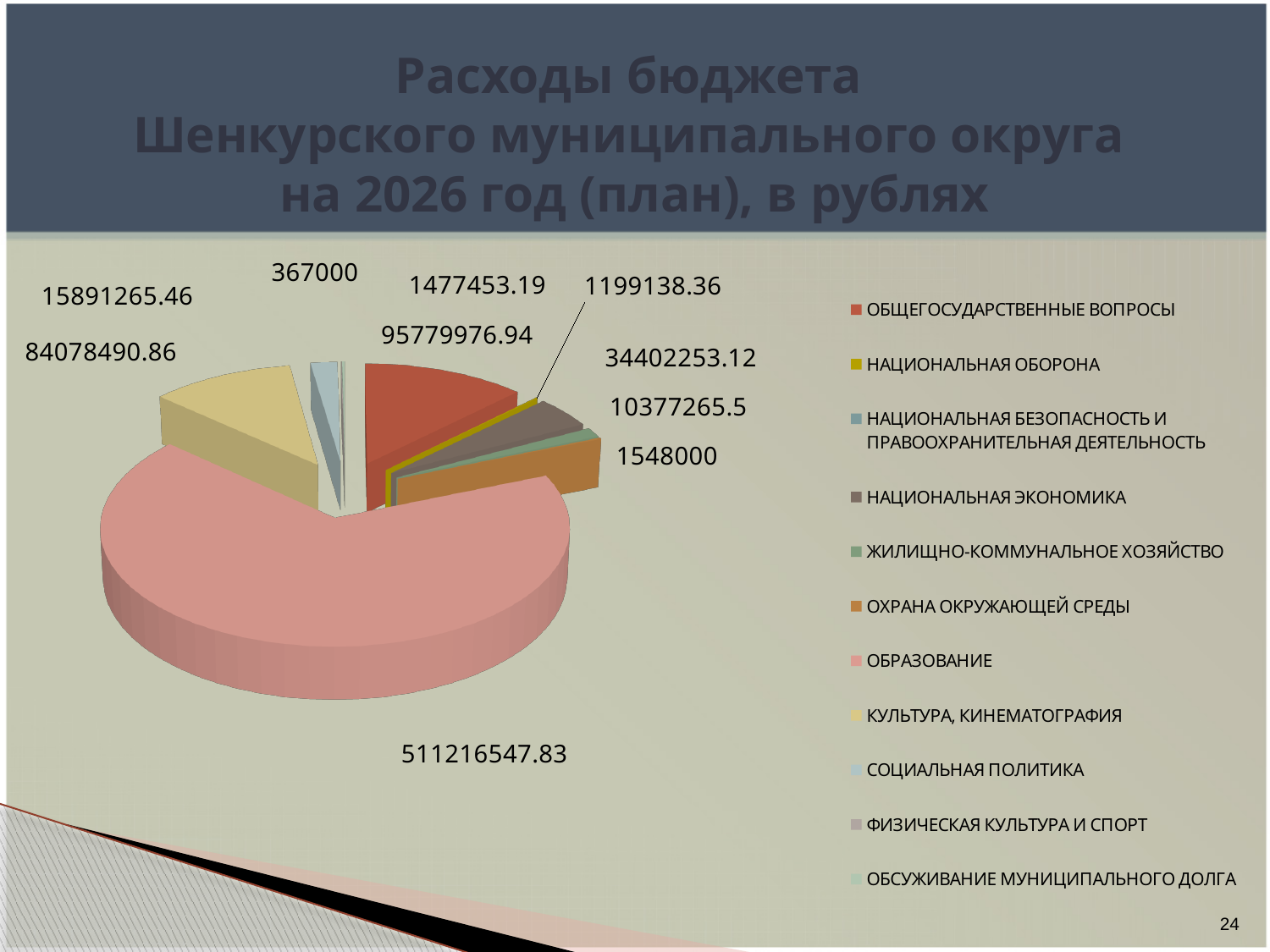
What is the planned expenditure for НАЦИОНАЛЬНАЯ ЭКОНОМИКА? 34402253.12 Which category has the largest share of the budget expenditures? ОБРАЗОВАНИЕ What is the planned expenditure for ОБЩЕГОСУДАРСТВЕННЫЕ ВОПРОСЫ? 95779976.94 What is the planned expenditure for КУЛЬТУРА, КИНЕМАТОГРАФИЯ? 84078490.86 What is the planned expenditure for ЖИЛИЩНО-КОММУНАЛЬНОЕ ХОЗЯЙСТВО? 10377265.5 What colour is the slice for ОБРАЗОВАНИЕ? pink How many categories does the legend list? 11 Which is larger: the expenditure for ОБЩЕГОСУДАРСТВЕННЫЕ ВОПРОСЫ or for КУЛЬТУРА, КИНЕМАТОГРАФИЯ? ОБЩЕГОСУДАРСТВЕННЫЕ ВОПРОСЫ What kind of chart is shown on the slide? pie chart What is the planned expenditure for ОБРАЗОВАНИЕ? 511216547.83 What is the difference between the expenditure for НАЦИОНАЛЬНАЯ ЭКОНОМИКА and for ЖИЛИЩНО-КОММУНАЛЬНОЕ ХОЗЯЙСТВО? 24024987.62 What is the difference between the expenditure for ОБЩЕГОСУДАРСТВЕННЫЕ ВОПРОСЫ and for КУЛЬТУРА, КИНЕМАТОГРАФИЯ? 11701486.08